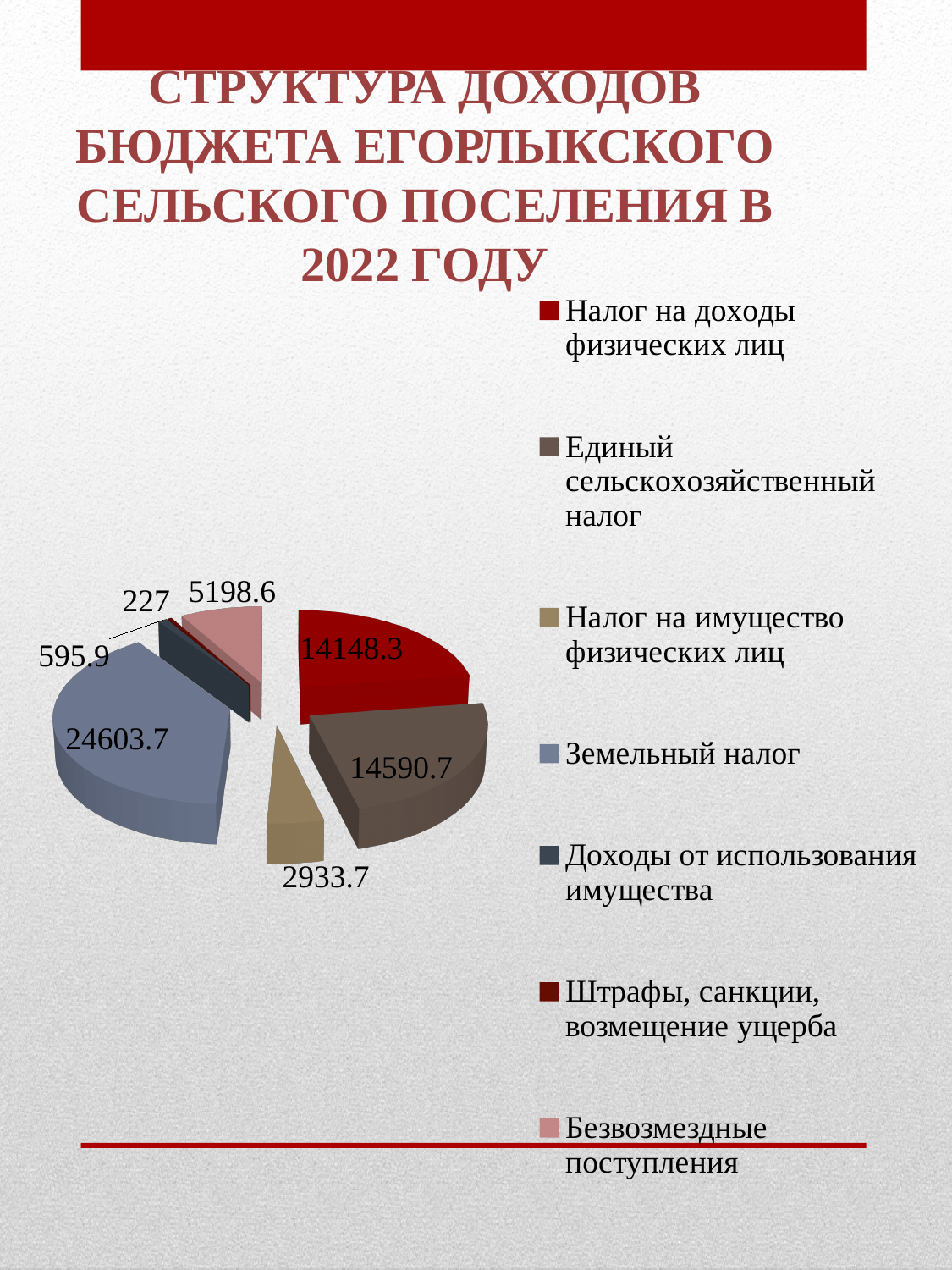
Which is larger: Безвозмездные поступления or Налог на имущество физических лиц? Безвозмездные поступления What is the difference between the values for Единый сельскохозяйственный налог and Налог на доходы физических лиц? 442.4 Which category has the largest slice of the pie? Земельный налог What type of chart is shown on the slide? Pie chart How many categories does the legend list? 7 What is the value shown for Штрафы, санкции, возмещение ущерба? 227 What is the value shown for Безвозмездные поступления? 5198.6 What is the value shown for Земельный налог? 24603.7 What is the difference between the values for Земельный налог and Единый сельскохозяйственный налог? 10013 What is the value shown for Доходы от использования имущества? 595.9 What is the value shown for Налог на доходы физических лиц? 14148.3 Which category has the smallest slice of the pie? Штрафы, санкции, возмещение ущерба